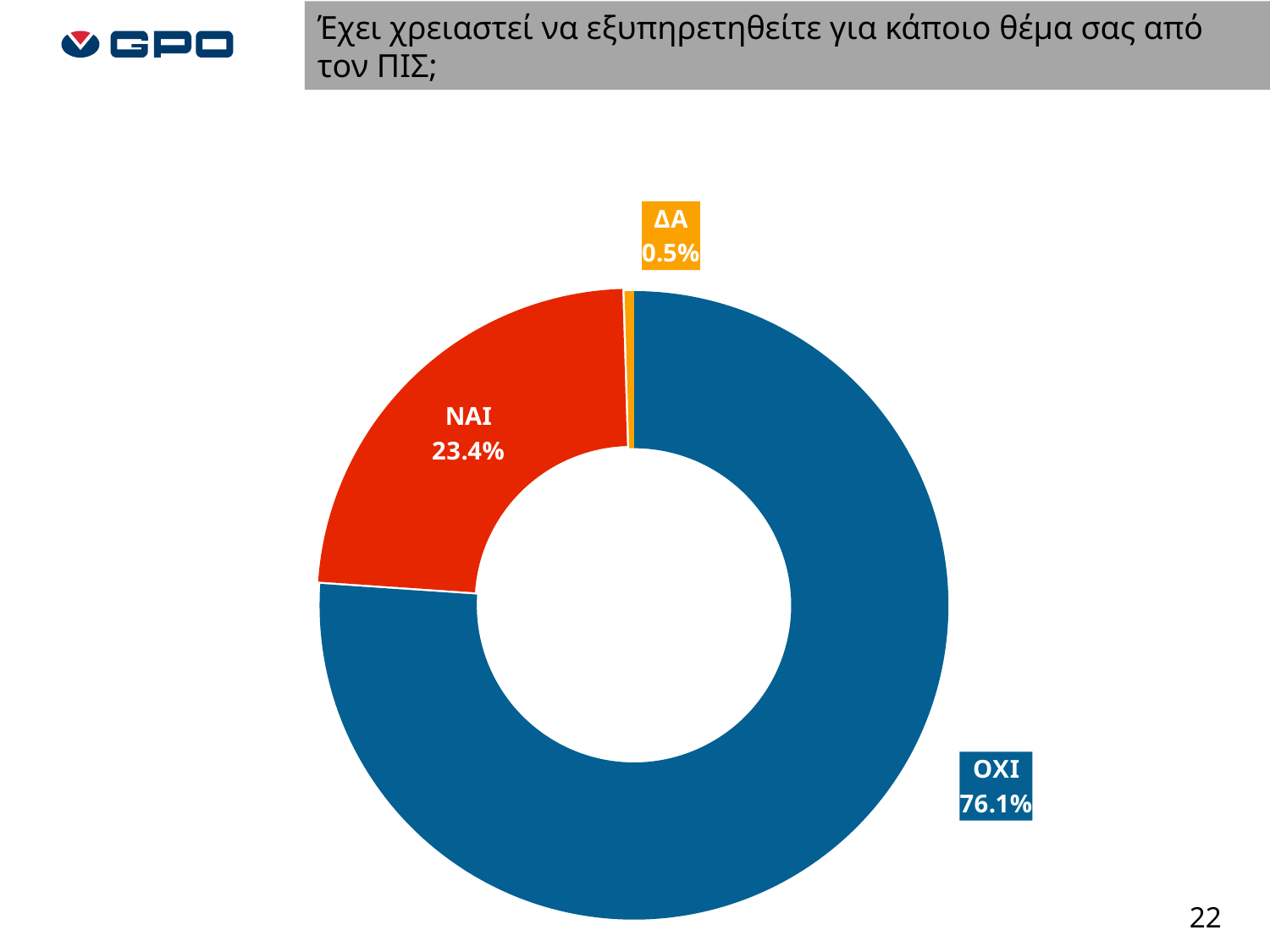
What type of chart is shown on the slide? Doughnut (pie) chart Which is larger, ΝΑΙ or ΔΑ? ΝΑΙ What is the value for ΝΑΙ? 23.4% Which category has the largest share? ΟΧΙ What share of the chart does the ΝΑΙ slice represent? 23.4% What is the value for ΔΑ? 0.5% What is the value for ΟΧΙ? 76.1% What is the difference between the ΟΧΙ and ΝΑΙ values? 52.7% How many categories are shown in the chart? 3 What colour is the ΟΧΙ slice? Blue Which category has the smallest share? ΔΑ What is the title of the slide? Έχει χρειαστεί να εξυπηρετηθείτε για κάποιο θέμα σας από τον ΠΙΣ;